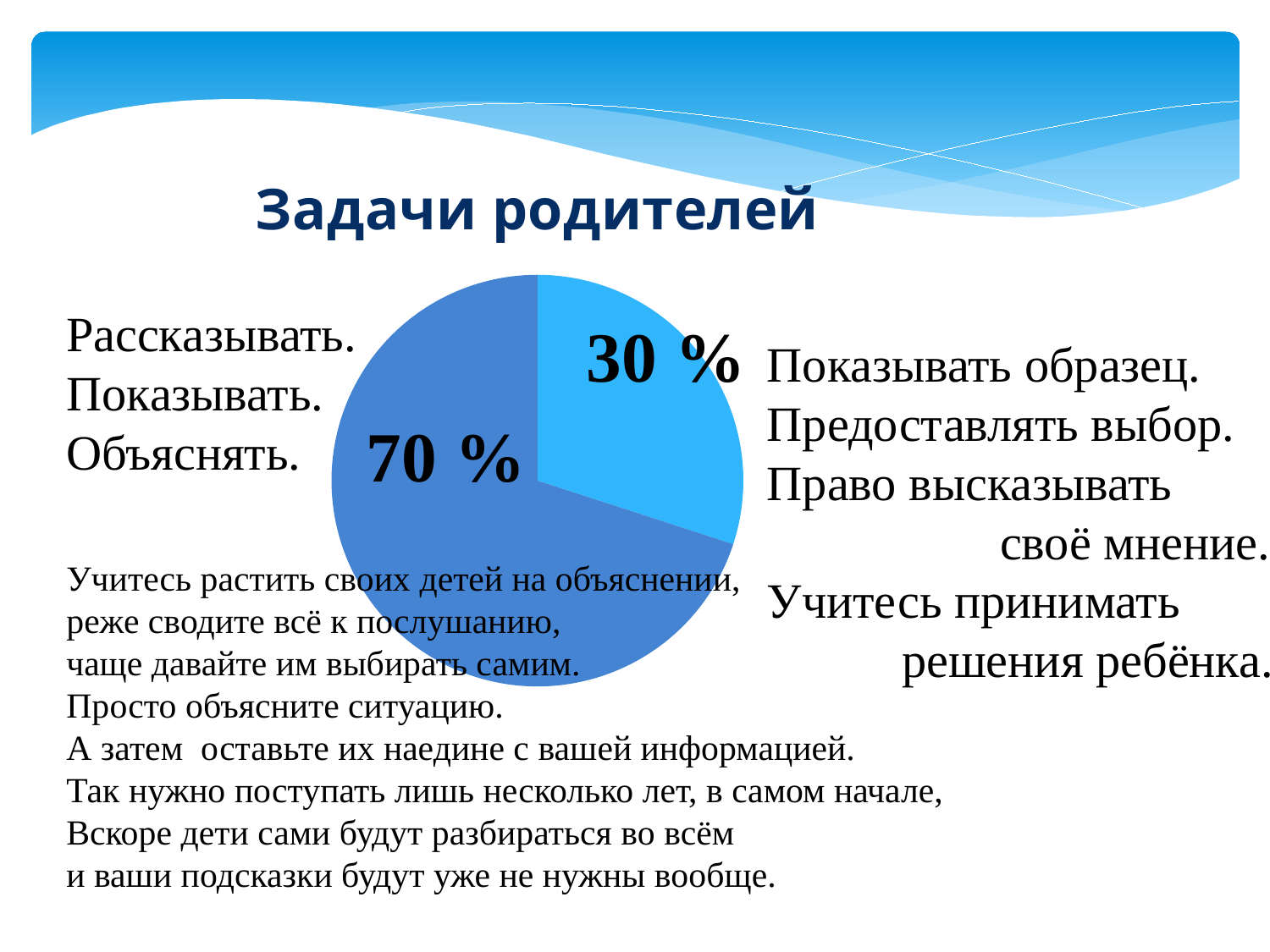
Which slice of the pie chart is the largest, the darker blue one or the lighter blue one? the darker blue one What is the difference between the two slice values shown on the pie chart? 40 % How many slices does the pie chart have? 2 Does the pie chart have a legend? no Which slice of the pie chart is the smallest, the darker blue one or the lighter blue one? the lighter blue one What is the title of the slide containing the pie chart? Задачи родителей Is the value of the darker blue slice larger or smaller than the value of the lighter blue slice? larger What kind of chart is shown on the slide? pie chart What share of the pie does the lighter blue slice represent? 30 % What is the total of the two slice values printed on the pie chart? 100 % What value is printed on the larger (darker blue) slice of the pie chart? 70 % What value is printed on the smaller (lighter blue) slice of the pie chart? 30 %